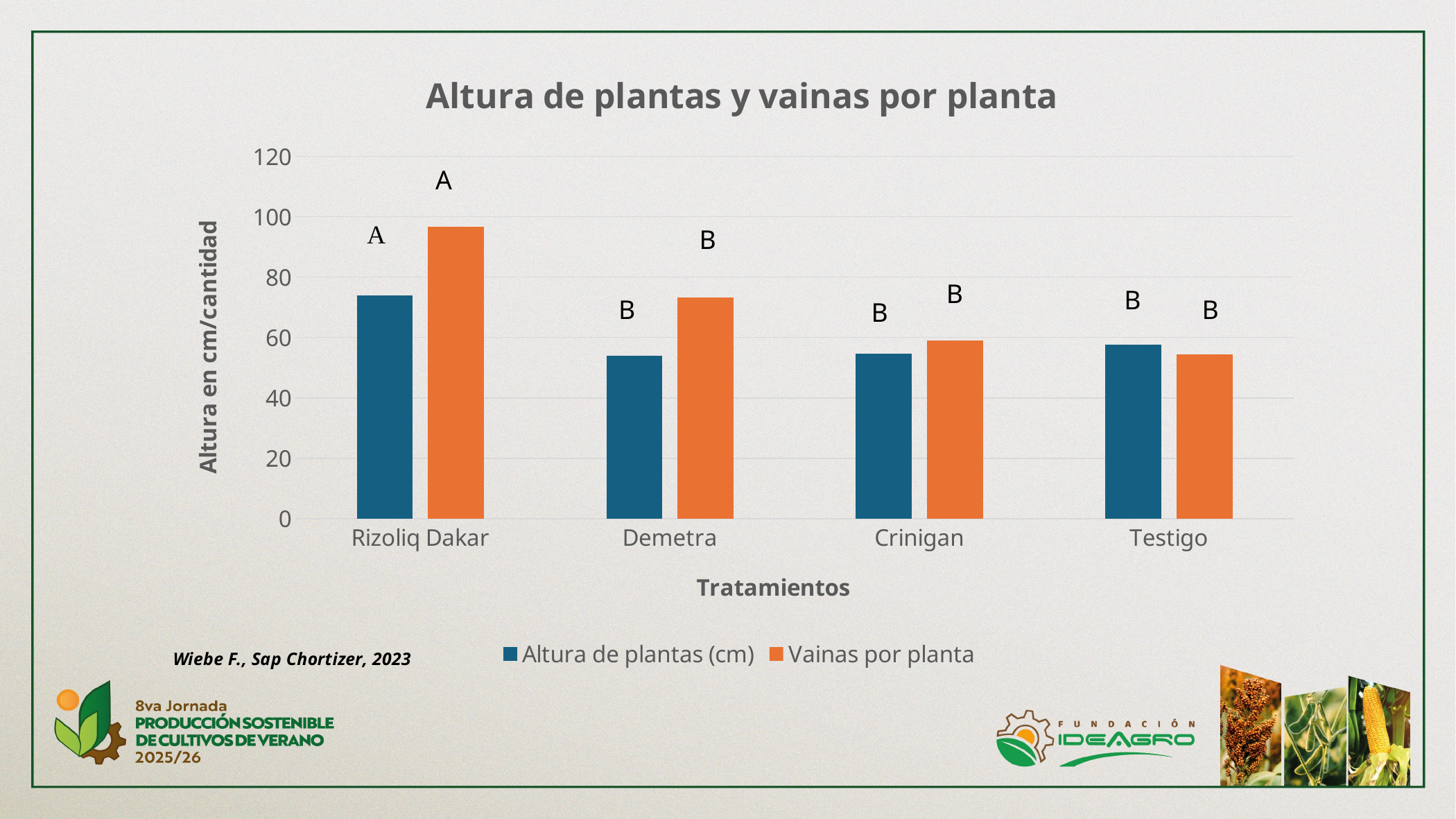
Is the Altura de plantas (cm) value for Demetra greater or less than 60? less Is the Altura de plantas (cm) value for Rizoliq Dakar greater or less than 60? greater Which treatment has the highest value for Altura de plantas (cm)? Rizoliq Dakar Which treatment has the highest value for Vainas por planta? Rizoliq Dakar How many treatments (categories) are shown on the x axis? 4 Is the Vainas por planta value for Rizoliq Dakar greater or less than 80? greater How many series does the legend list? 2 For Demetra, which is larger: Altura de plantas (cm) or Vainas por planta? Vainas por planta What is the label of the x axis? Tratamientos What kind of chart is shown on the slide? bar chart What is the title of the chart? Altura de plantas y vainas por planta